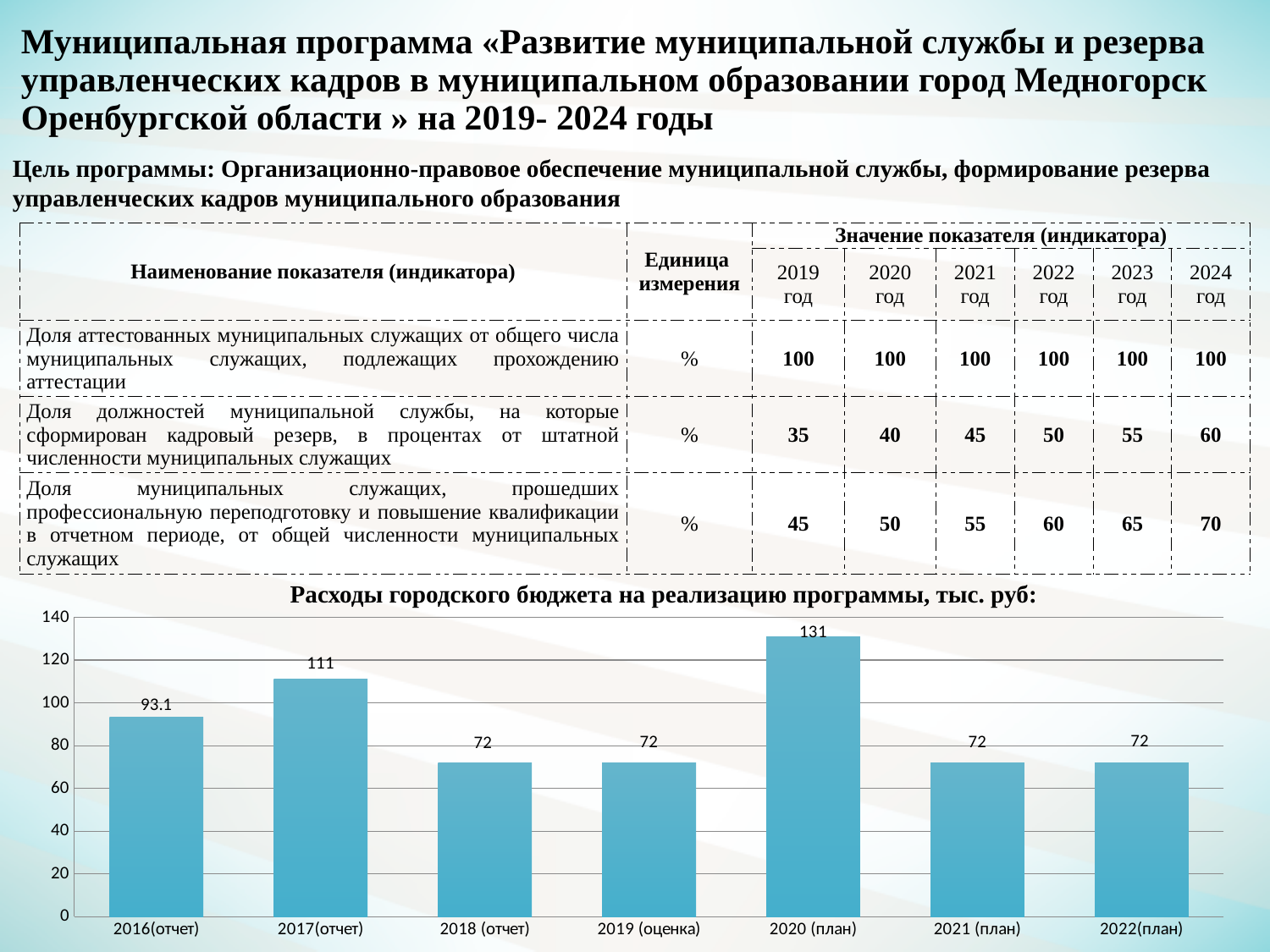
What kind of chart is shown on the slide? bar chart Which is larger, the value for 2016(отчет) or the value for 2019 (оценка)? 2016(отчет) What is the difference between the values for 2020 (план) and 2017(отчет)? 20 How many categories are shown on the x axis of the chart? 7 Which category has the highest value in the chart? 2020 (план) What is the value for 2020 (план) in the chart? 131 Is the value for 2020 (план) greater or less than 120? greater What is the value for 2017(отчет) in the chart? 111 What is the value for 2016(отчет) in the chart 'Расходы городского бюджета на реализацию программы, тыс. руб:'? 93.1 What is the title of the chart on the slide? Расходы городского бюджета на реализацию программы, тыс. руб: What is the difference between the values for 2017(отчет) and 2018 (отчет)? 39 How many categories in the chart have a value of 72? 4